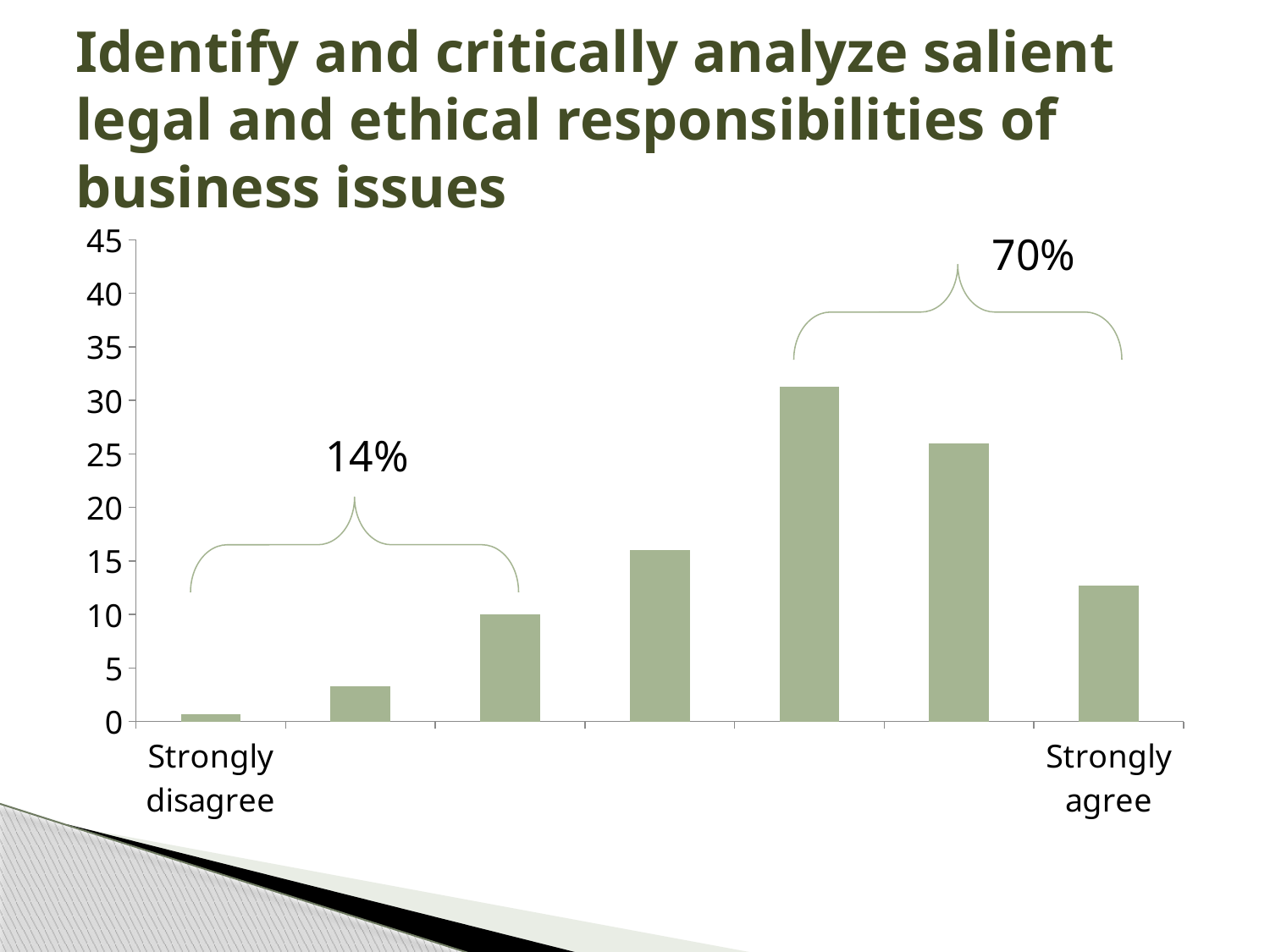
What kind of chart is shown on the slide? bar chart What is the highest value shown on the vertical axis? 45 Is the value for Strongly disagree greater or less than 5? less Is the tallest bar in the chart greater or less than 30? greater Which is larger, the bar for Strongly agree or the bar for Strongly disagree? Strongly agree How many bars are plotted in the chart? 7 What is the title of the slide containing the chart? Identify and critically analyze salient legal and ethical responsibilities of business issues What percentage is annotated above the three bars nearest Strongly disagree? 14% What percentage is annotated above the three bars nearest Strongly agree? 70% Is the value for Strongly agree greater or less than 15? less Which labelled category has the lowest bar, Strongly disagree or Strongly agree? Strongly disagree